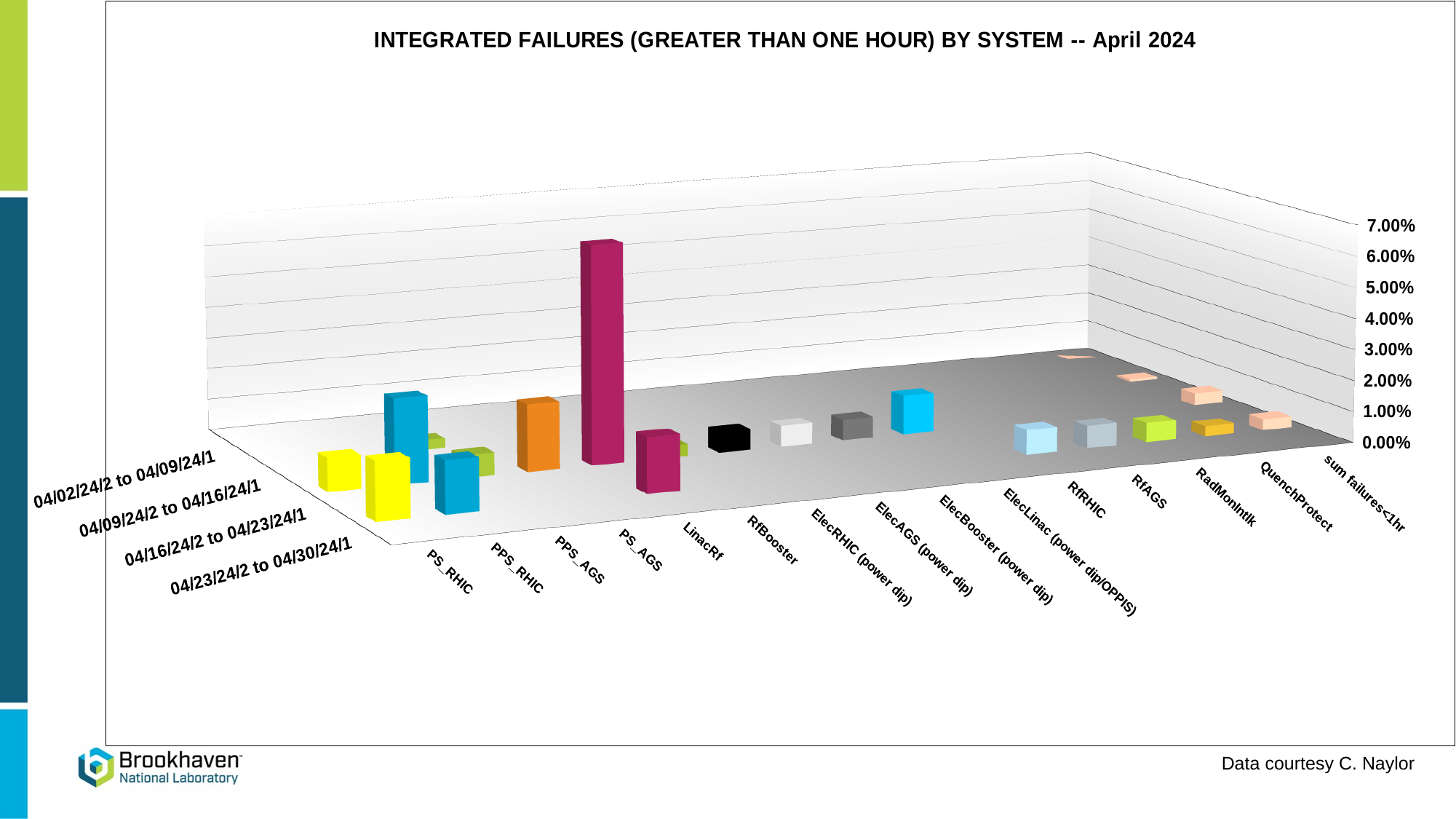
How many system categories are listed along the horizontal axis of the chart? 15 Is the tallest bar for RfBooster greater or less than 2.00%? less Is the tallest bar for PPS_AGS greater or less than 4.00%? less What is the highest value shown on the vertical axis of the chart? 7.00% Is the tallest bar for PS_AGS greater or less than 3.00%? less How many weekly time periods are shown along the depth axis of the chart? 4 Which system has the tallest bar in the chart? LinacRf What type of chart is shown on the slide? bar chart Which is larger, the tallest bar for PS_AGS or the tallest bar for PPS_AGS? PS_AGS What is the title of the chart? INTEGRATED FAILURES (GREATER THAN ONE HOUR) BY SYSTEM -- April 2024